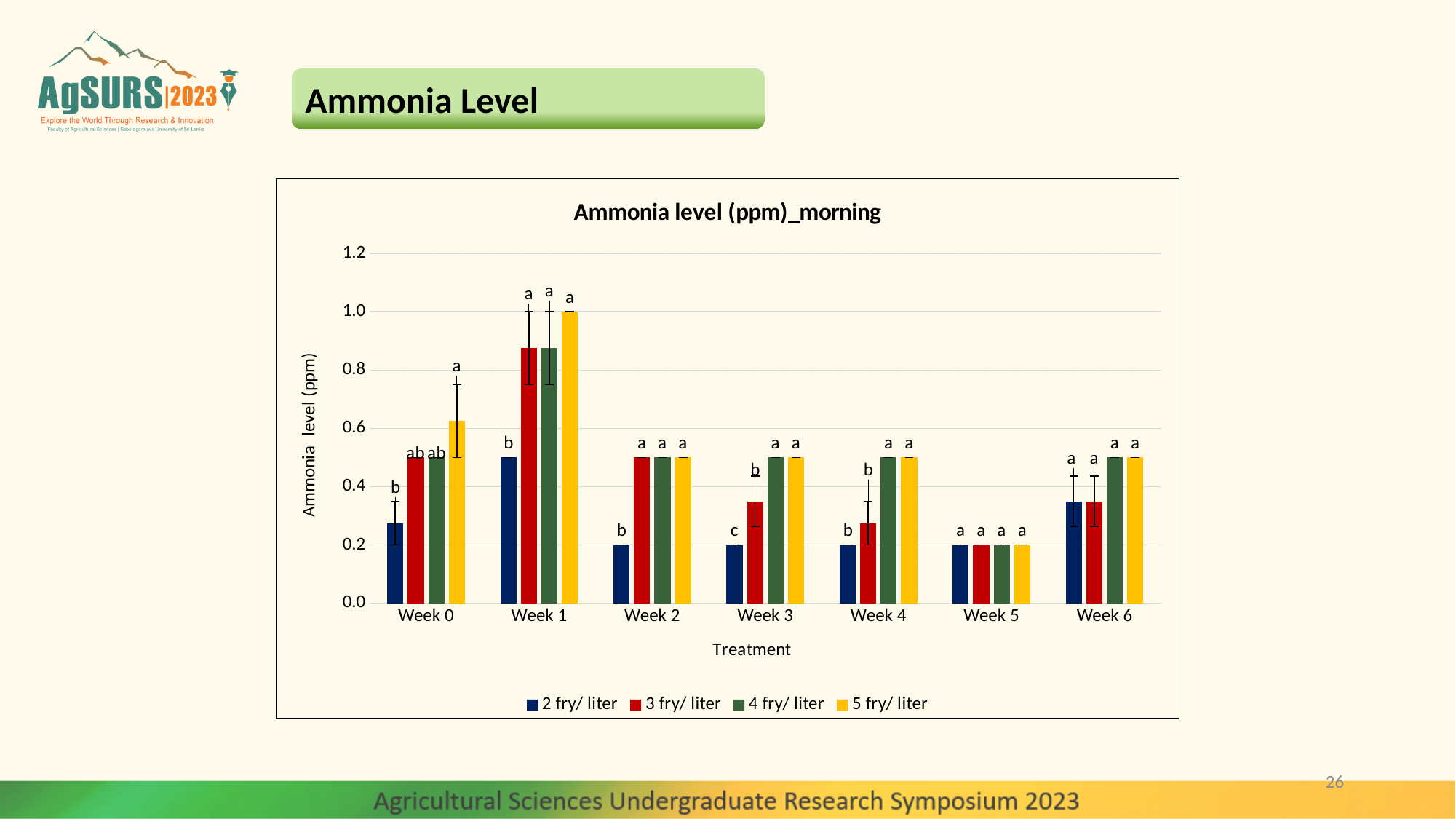
In which week is the 5 fry/ liter value highest? Week 1 How many week categories are shown on the x axis? 7 What is the ammonia level for 2 fry/ liter in Week 5? 0.2 Is the value for 5 fry/ liter in Week 0 greater or less than 0.8? less What kind of chart is shown on the slide? bar chart In Week 3, which series has the lowest value? 2 fry/ liter How many series does the legend list? 4 What is the title of the chart? Ammonia level (ppm)_morning What is the ammonia level for 5 fry/ liter in Week 1? 1.0 Is the value for 3 fry/ liter in Week 1 greater or less than 0.8? greater In Week 3, which is larger: the value for 3 fry/ liter or for 4 fry/ liter? 4 fry/ liter Is the value for 2 fry/ liter in Week 6 greater or less than 0.4? less